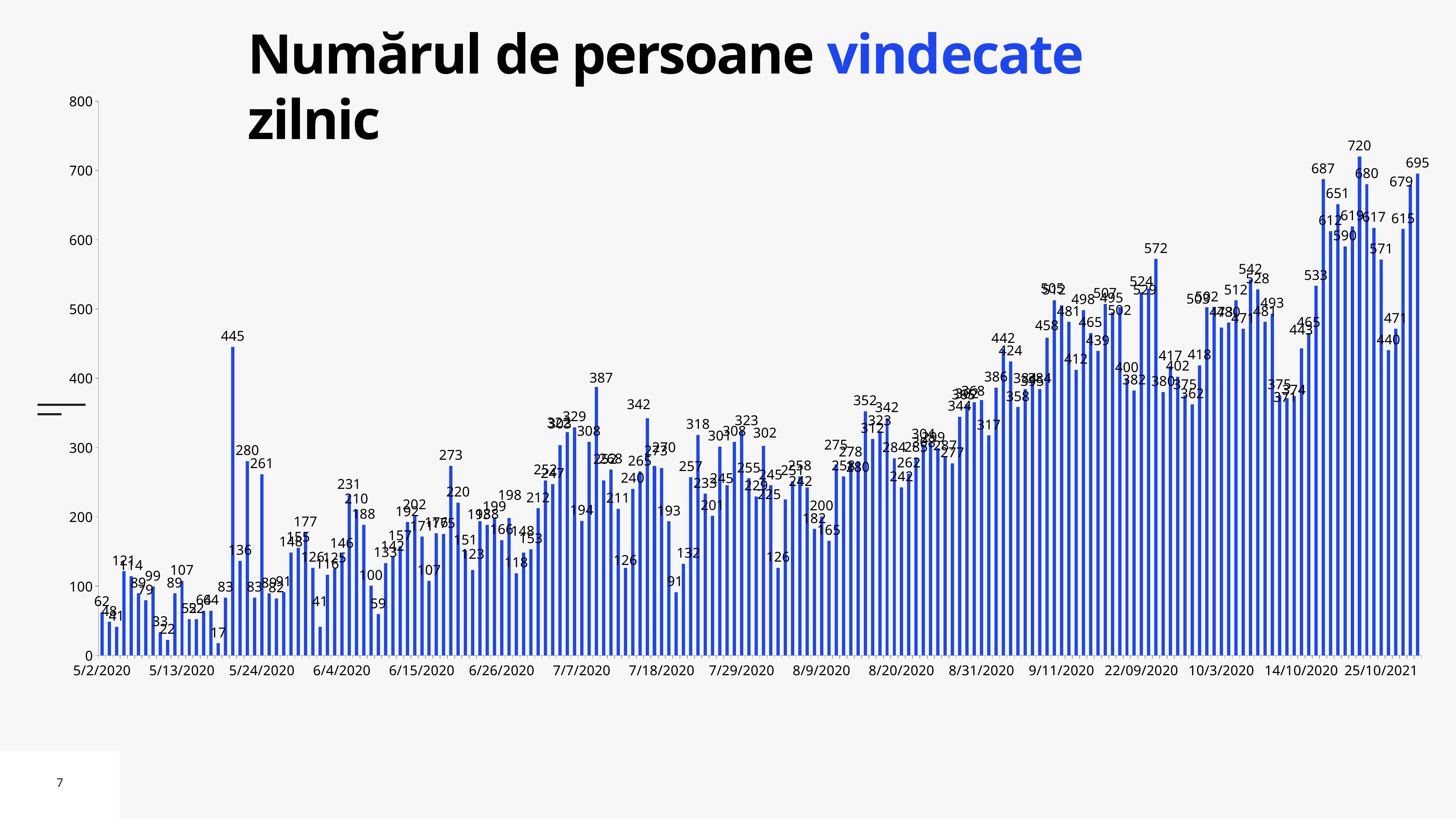
What is the value of the rightmost (last) bar in the chart? 695 What is the lowest value shown in the chart? 17 Is the value of the first bar (5/2/2020) greater or less than 100? less What is the maximum value shown on the vertical axis? 800 What is the title of the chart? Numărul de persoane vindecate zilnic What is the highest value shown in the chart? 720 What is the value of the first bar, for 5/2/2020? 62 Which is larger, the bar labelled 687 or the bar labelled 651? 687 What kind of chart is shown on the slide? bar chart Do the values generally rise or fall from left to right along the x axis? rise What is the difference between the bar labelled 720 and the bar labelled 687? 33 What is the difference between the highest value (720) and the last bar's value (695)? 25